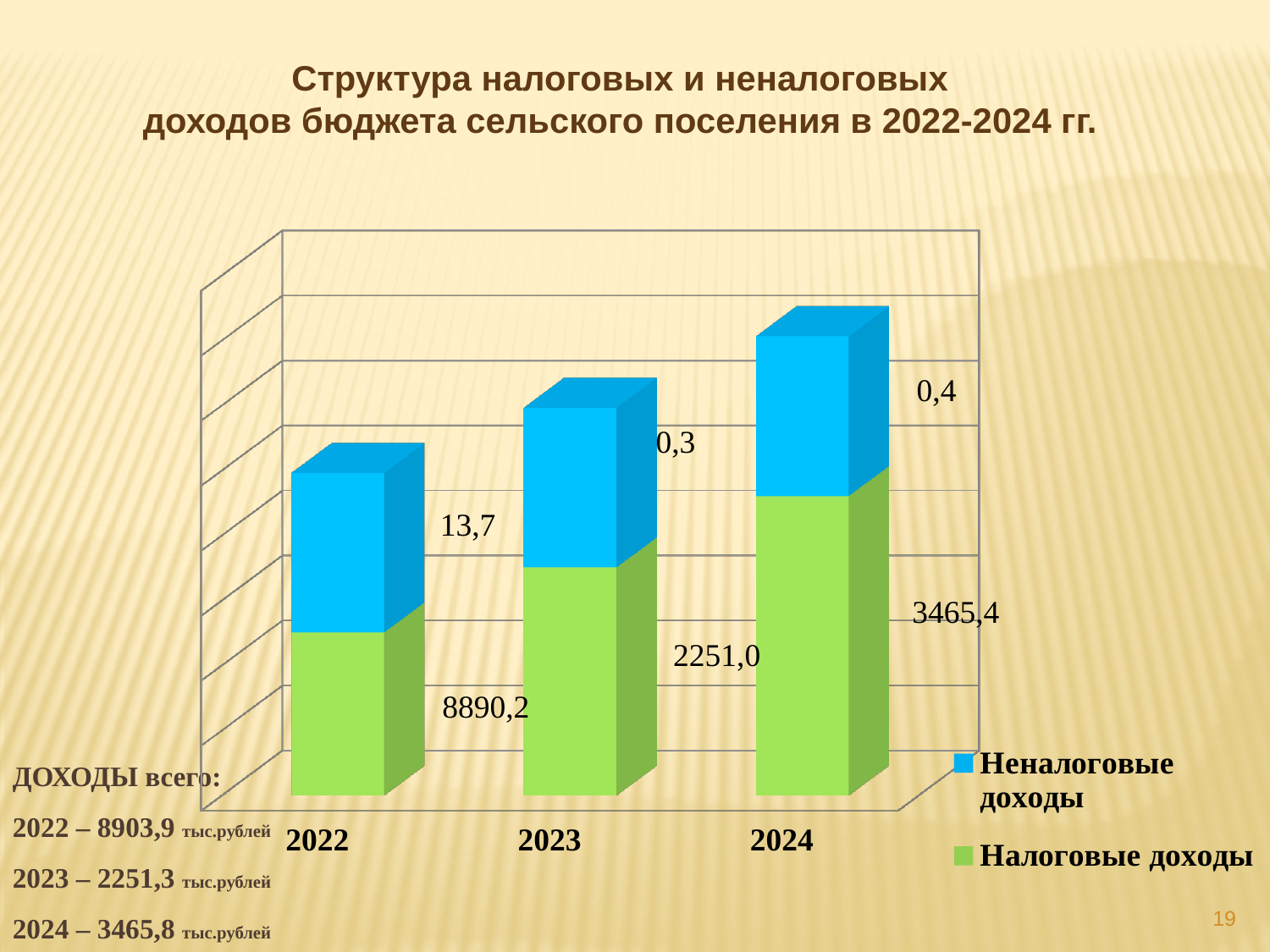
How many years (categories) are shown on the x axis? 3 What is the value of Неналоговые доходы for 2023? 0,3 What is the value of Налоговые доходы for 2024? 3465,4 How many series does the legend list? 2 What is the difference between Налоговые доходы in 2024 and in 2023? 1214,4 Which colour represents Неналоговые доходы in the legend? Blue What is the value of Неналоговые доходы for 2022? 13,7 What is the value of Налоговые доходы for 2022? 8890,2 What is the total of the stacked bar for 2024 (Налоговые доходы plus Неналоговые доходы)? 3465,8 What type of chart is shown on the slide? Stacked bar chart